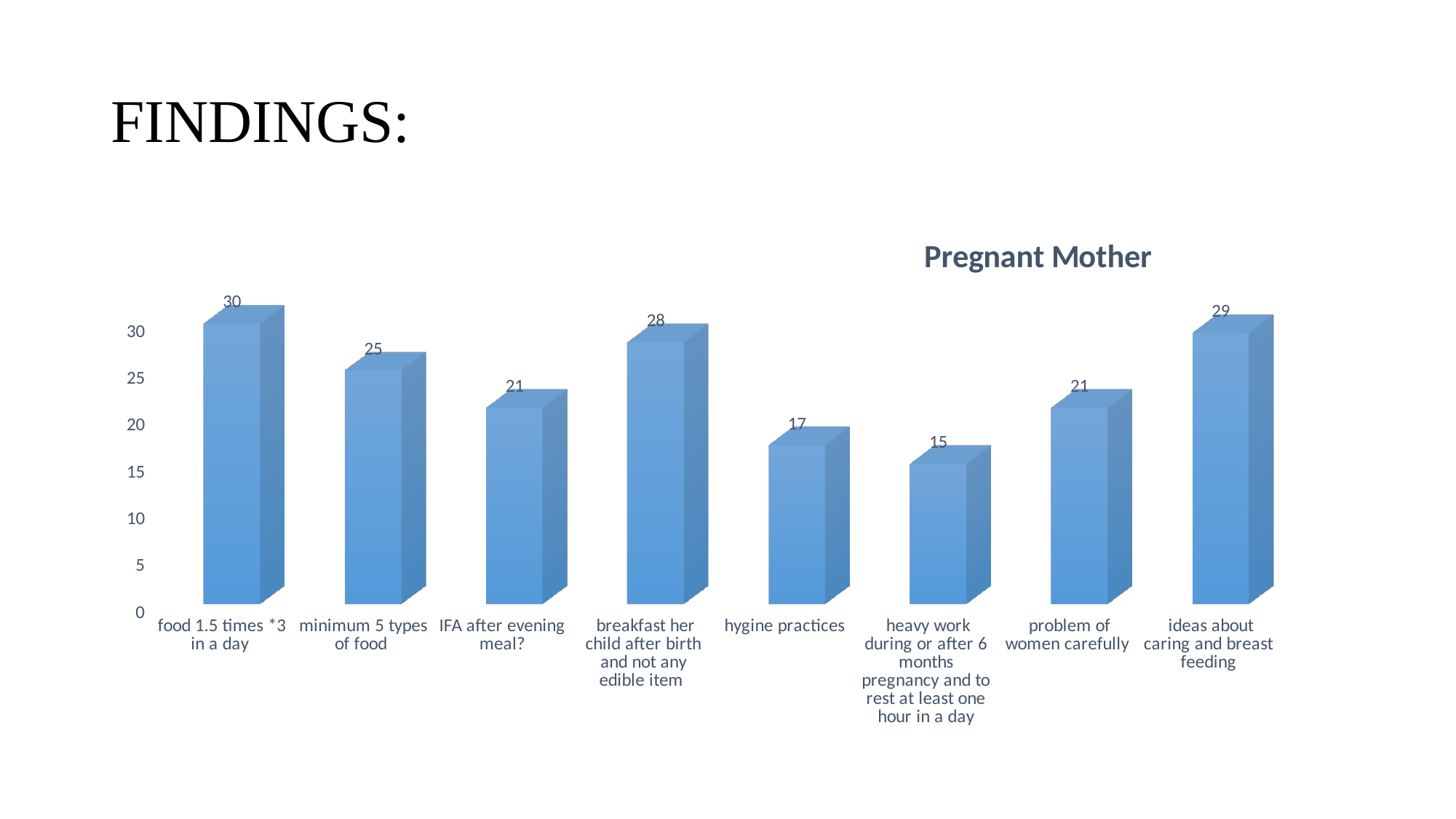
What is the title of the chart? Pregnant Mother What is the difference between the values for "IFA after evening meal?" and "heavy work during or after 6 months pregnancy and to rest at least one hour in a day"? 6 What is the value for "minimum 5 types of food"? 25 Which category has the highest value? food 1.5 times *3 in a day Which is larger: the value for "minimum 5 types of food" or the value for "problem of women carefully"? minimum 5 types of food What is the value for "ideas about caring and breast feeding"? 29 What kind of chart is shown on the slide? bar chart What is the difference between the values for "food 1.5 times *3 in a day" and "breakfast her child after birth and not any edible item"? 2 What is the value for "hygine practices"? 17 Which category has the lowest value? heavy work during or after 6 months pregnancy and to rest at least one hour in a day How many categories are shown in the chart? 8 Is the value for "hygine practices" greater or less than 20? less